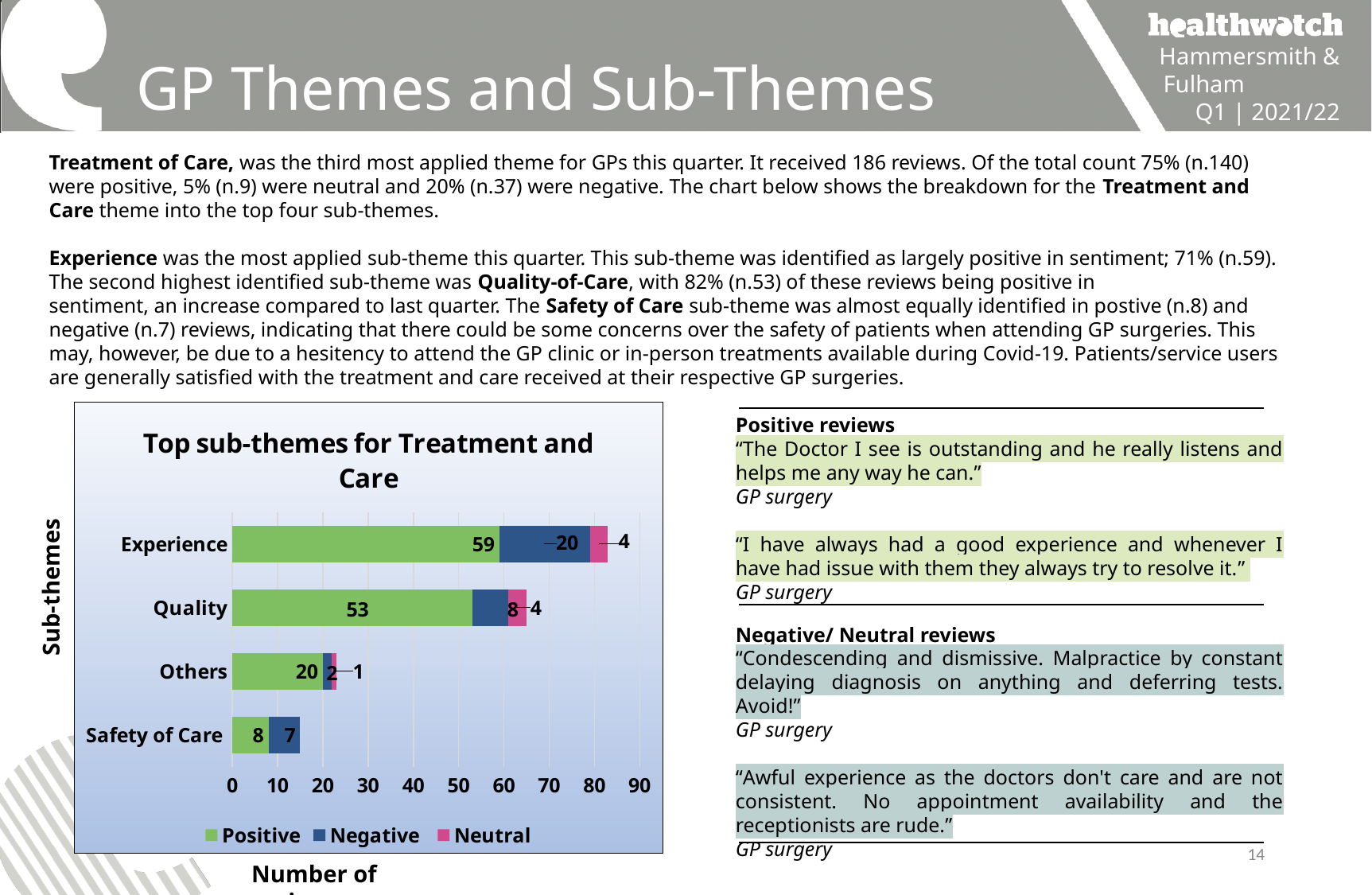
What is the Negative value for Safety of Care in the chart? 7 How many series does the chart legend list? 3 What is the Positive value for Experience in the chart? 59 What is the difference between the Positive values for Experience and Quality? 6 What is the Negative value for Quality in the chart? 8 What type of chart is shown on the slide? bar chart What is the Neutral value for Others in the chart? 1 How many sub-themes are shown in the chart? 4 Which is larger, the Negative value for Experience or the Negative value for Quality? Experience Which sub-theme has the highest Positive value? Experience Which sub-theme has the lowest Positive value? Safety of Care What is the total of the stacked bar for Experience? 83